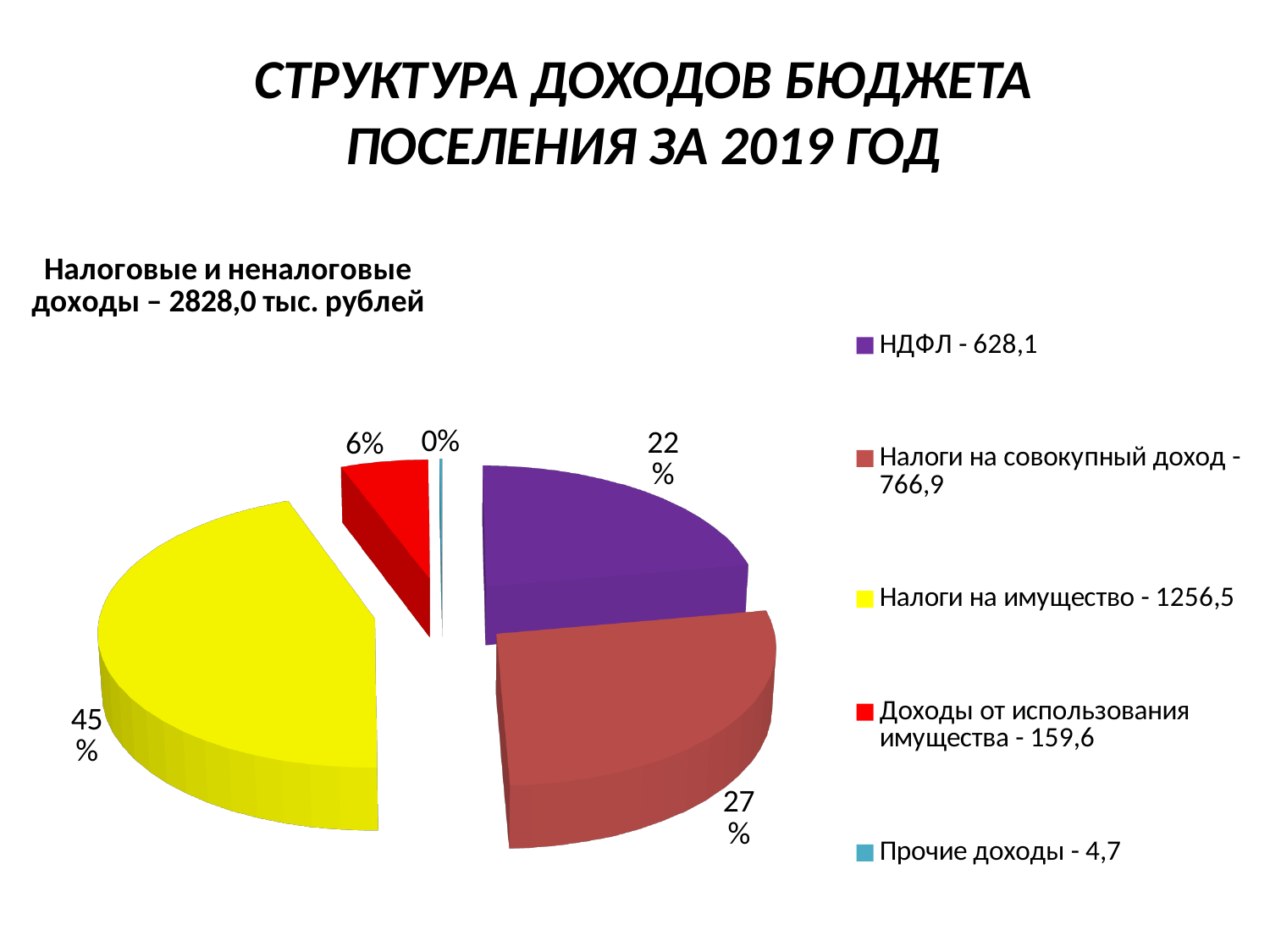
What kind of chart is shown on the slide? pie chart What share of the pie does Налоги на совокупный доход have? 27% What share of the pie does Налоги на имущество have? 45% What is the difference in percentage points between the Налоги на имущество slice and the НДФЛ slice? 23 What share of the pie does Прочие доходы have? 0% Which category has the largest slice of the pie? Налоги на имущество Which category has the smallest slice of the pie? Прочие доходы How many categories does the legend list? 5 What value is shown in the legend for Налоги на имущество? 1256,5 Which slice is larger: НДФЛ or Налоги на совокупный доход? Налоги на совокупный доход